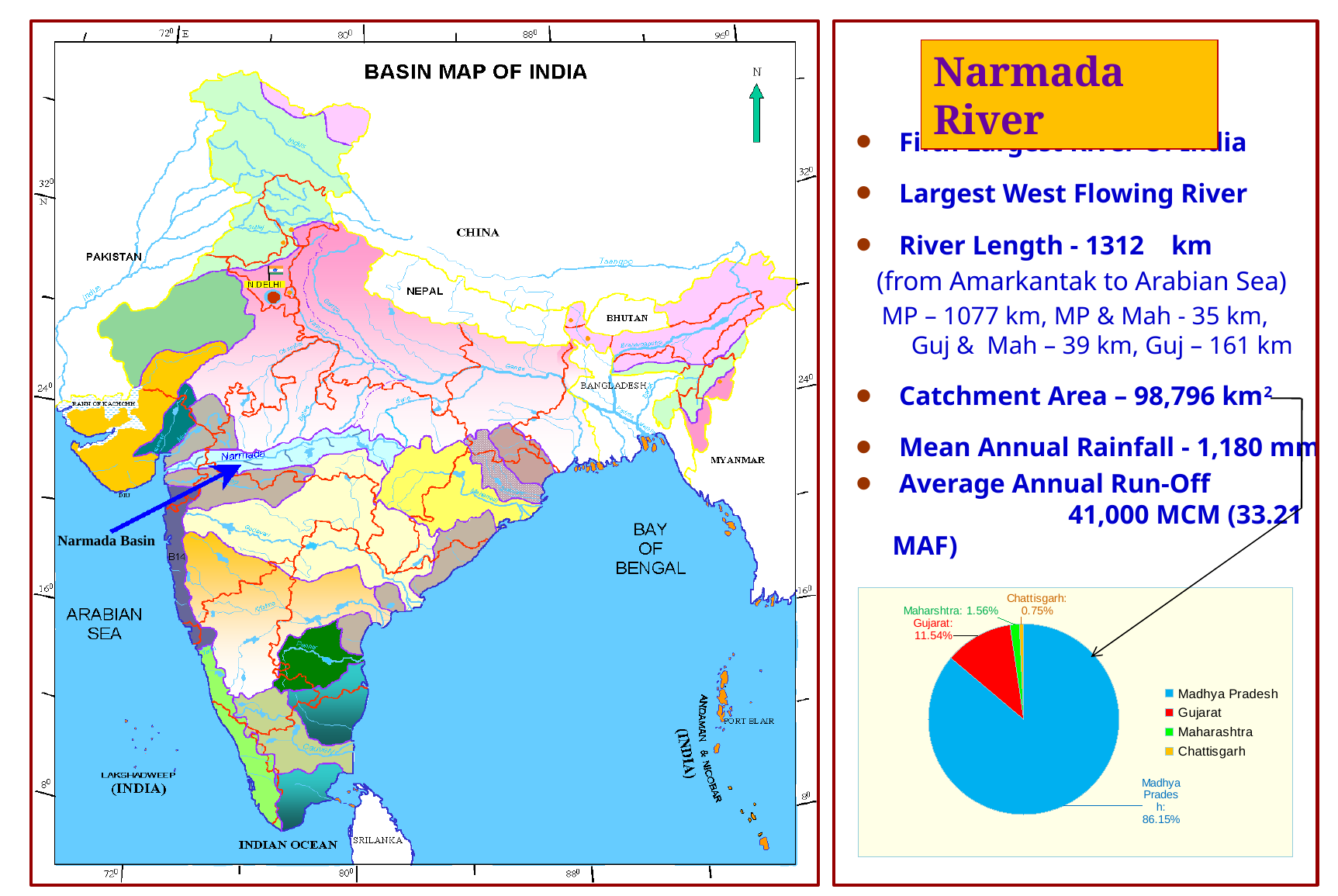
What share of the pie chart does Chattisgarh have? 0.75% How many entries does the pie chart legend list? 4 What share of the pie chart does Maharashtra have? 1.56% How many slices does the pie chart have? 4 What share of the pie chart does Gujarat have? 11.54% Which has a larger share in the pie chart, Gujarat or Maharashtra? Gujarat Which state has the smallest slice in the pie chart? Chattisgarh What kind of chart is shown on the slide? pie chart What is the difference in percentage points between the Madhya Pradesh and Gujarat shares in the pie chart? 74.61 Which state has the largest slice in the pie chart? Madhya Pradesh What share of the pie chart does Madhya Pradesh have? 86.15% What colour is the Gujarat slice in the pie chart? red